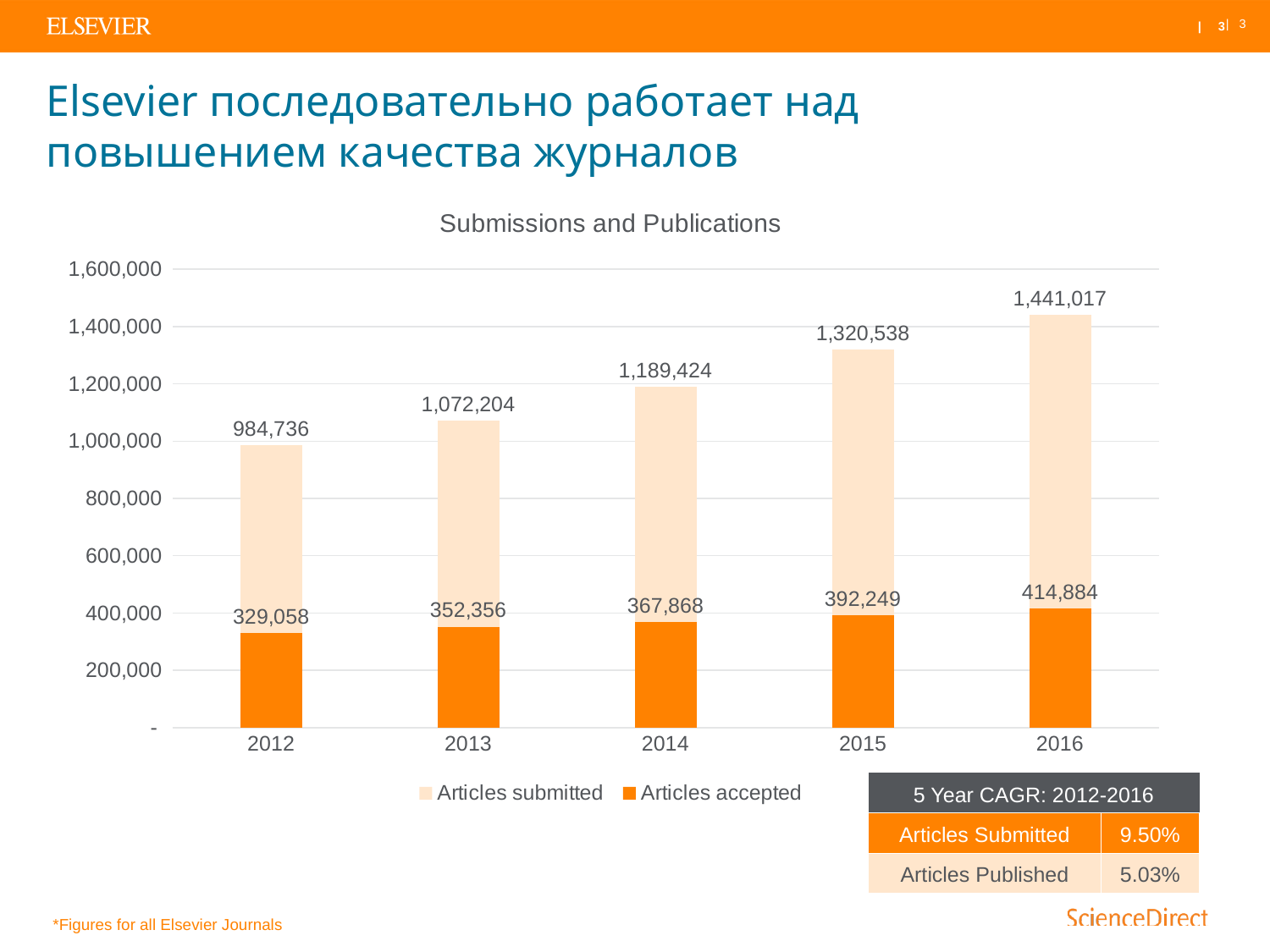
What is the value for Articles submitted in 2014? 1,189,424 What is the difference between Articles submitted and Articles accepted in 2015? 928,289 Which year has the lowest value for Articles accepted? 2012 Do the values for Articles submitted rise or fall from 2012 to 2016? rise What is the title of the chart? Submissions and Publications Which is larger: Articles accepted in 2013 or Articles accepted in 2014? 2014 What is the value for Articles accepted in 2016? 414,884 What is the value for Articles accepted in 2012? 329,058 Which year has the highest value for Articles submitted? 2016 What type of chart is shown on the slide? bar chart How many years are shown on the x axis of the chart? 5 How many series does the chart legend list? 2